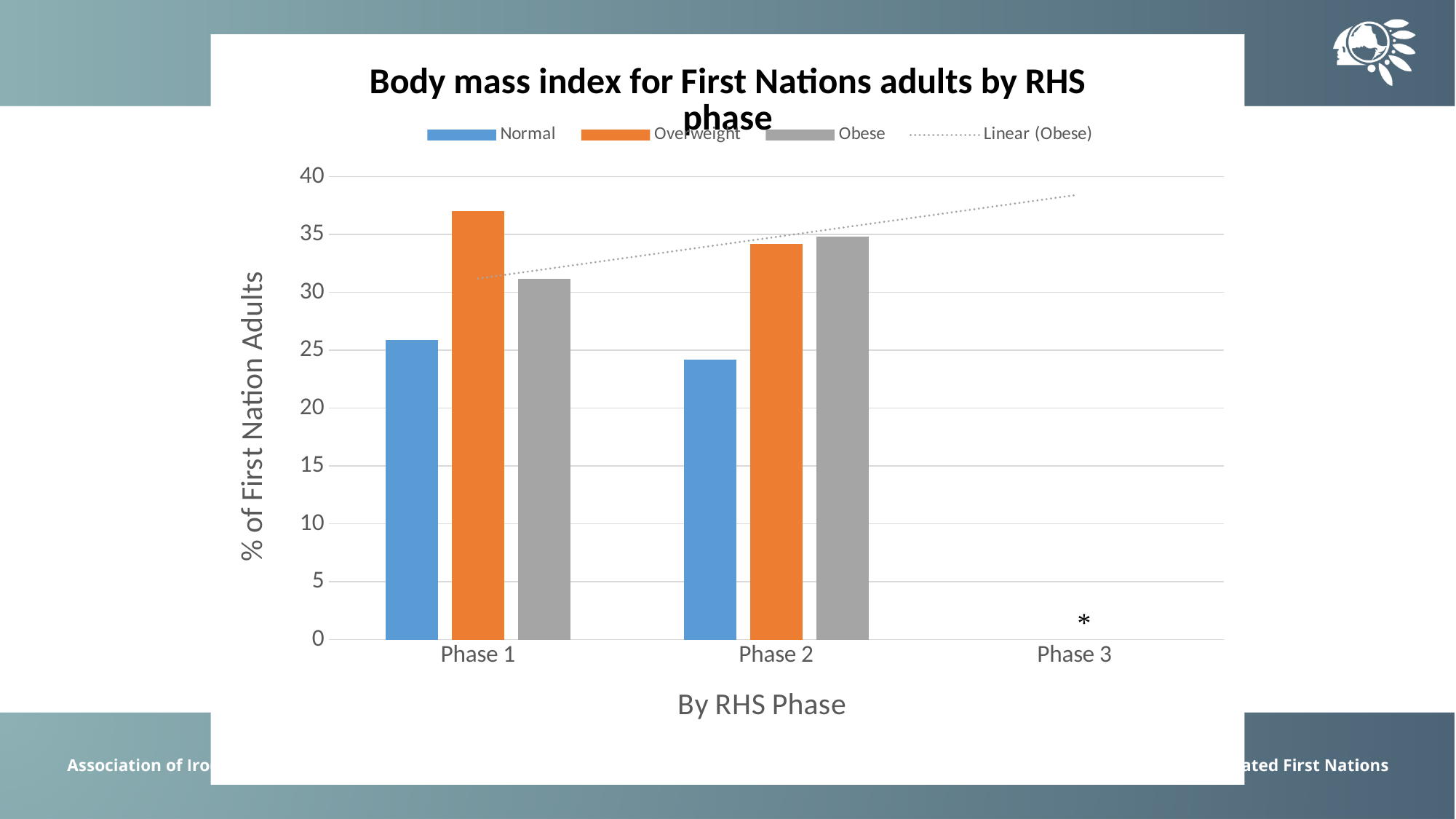
What kind of chart is shown on the slide? Bar chart Which is larger, the Normal value for Phase 1 or the Normal value for Phase 2? Phase 1 Is the Overweight value for Phase 2 greater or less than 30? greater What is the label on the y axis of the chart? % of First Nation Adults Is the Normal value for Phase 1 greater or less than 30? less Is the Overweight value for Phase 1 greater or less than 35? greater Which series has the shortest bar in Phase 2? Normal How many entries does the chart legend list? 4 Which series has the tallest bar in Phase 1? Overweight How many RHS phases are shown on the x axis? 3 Does the Obese value rise or fall from Phase 1 to Phase 2? Rise